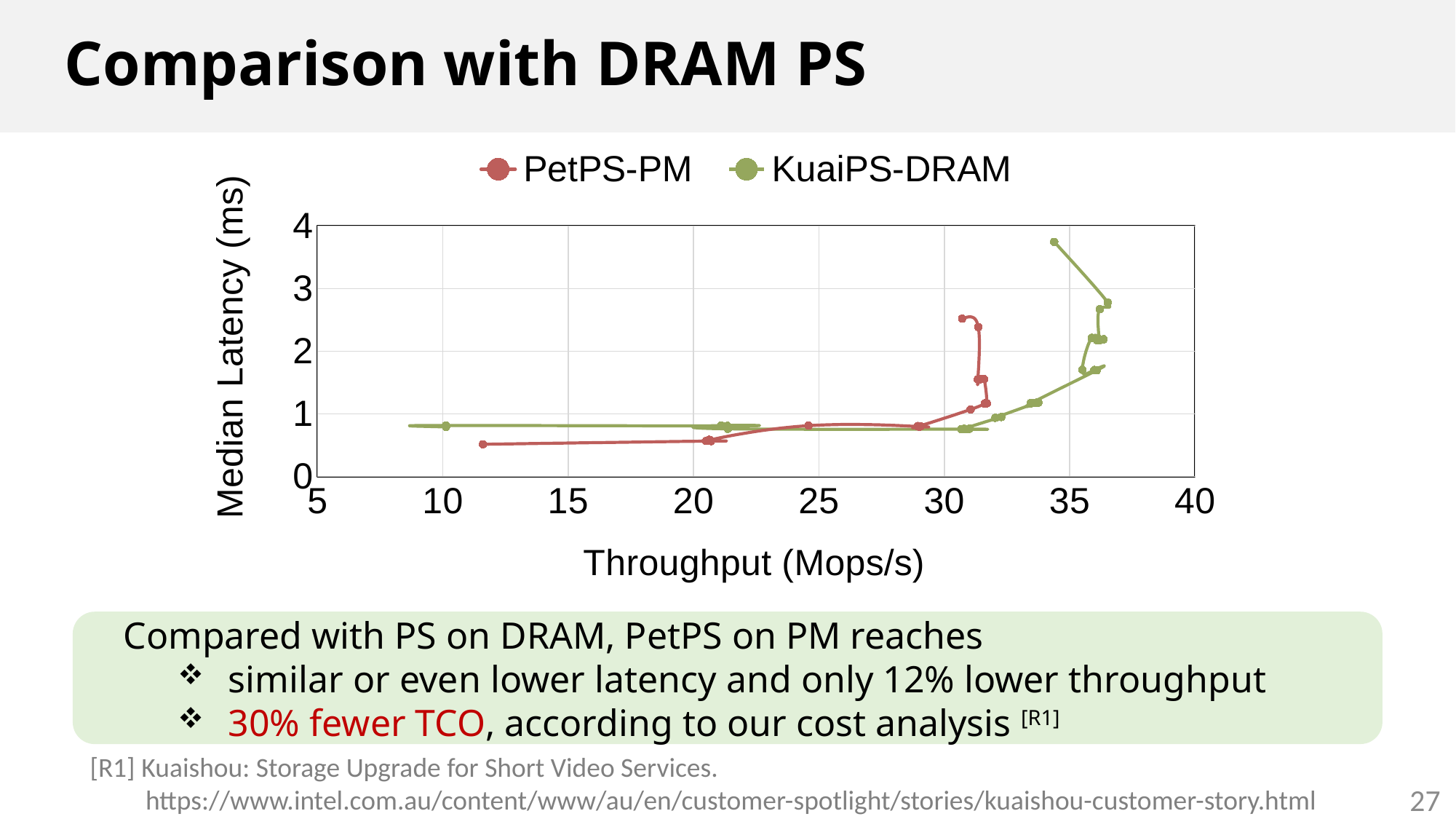
Is the highest median latency reached by PetPS-PM greater or less than 2 ms? greater Is the highest median latency reached by KuaiPS-DRAM greater or less than 3 ms? greater Which series reaches the higher maximum throughput, PetPS-PM or KuaiPS-DRAM? KuaiPS-DRAM Which series reaches the higher maximum median latency, PetPS-PM or KuaiPS-DRAM? KuaiPS-DRAM How many series does the chart legend list? 2 Is the maximum throughput reached by PetPS-PM greater or less than 35 Mops/s? less What kind of chart is shown on the slide? Line chart What is the label of the y axis of the chart? Median Latency (ms) As throughput increases toward its maximum, does the median latency of KuaiPS-DRAM rise or fall? rise What is the label of the x axis of the chart? Throughput (Mops/s) Which series has the lowest median latency value plotted on the chart? PetPS-PM